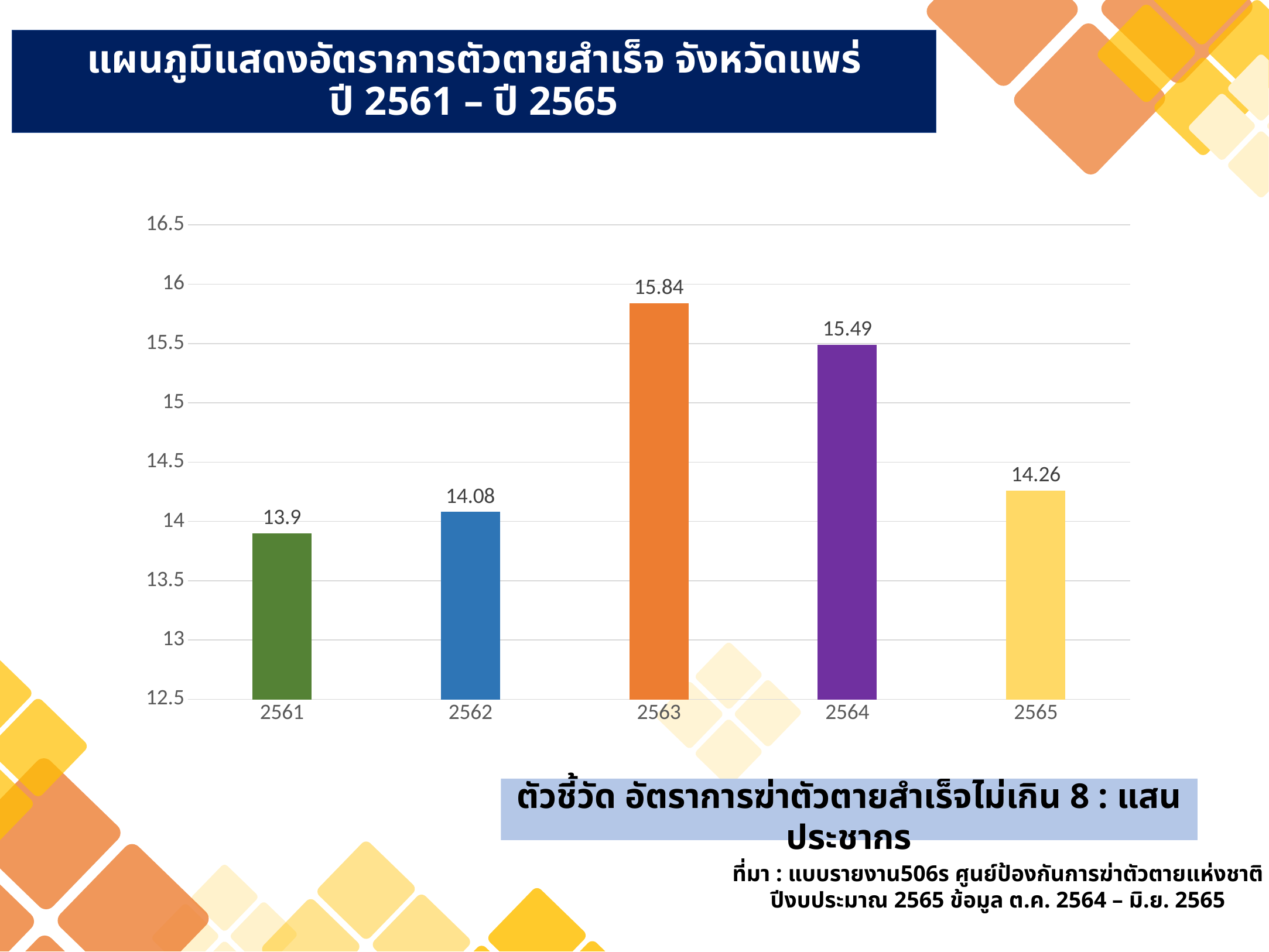
What colour is the bar for 2563? orange Which year has the highest value? 2563 What kind of chart is shown on the slide? bar chart How many years are shown on the x axis? 5 Is the value for 2562 greater or less than 14.5? less Which year has the lowest value? 2561 What is the value for 2563? 15.84 Which is larger, the value for 2564 or the value for 2565? 2564 What is the difference between the values for 2562 and 2561? 0.18 What is the value for 2565? 14.26 What is the value for 2561? 13.9 What is the difference between the values for 2563 and 2564? 0.35